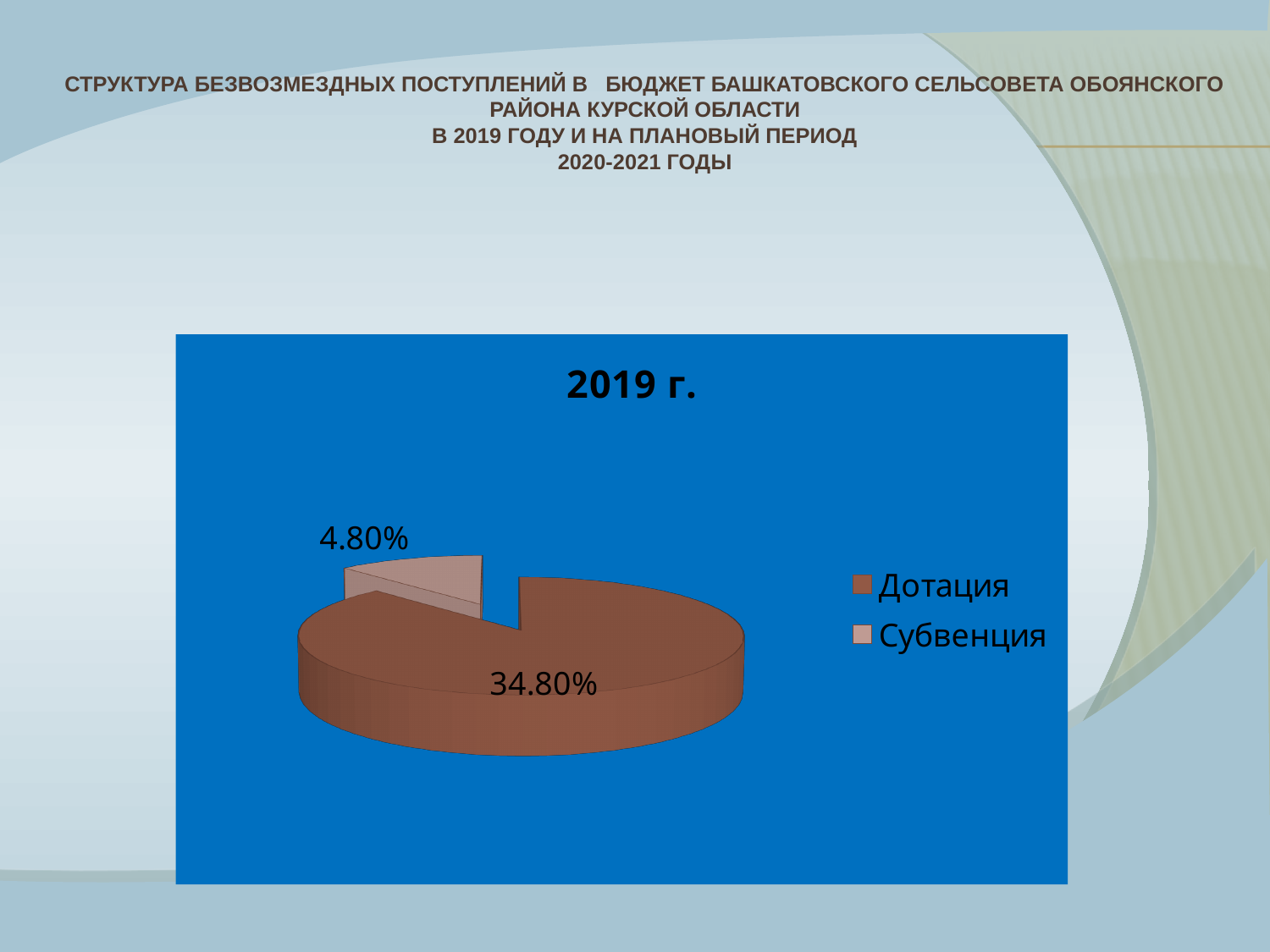
What value is labelled on the Дотация slice? 34.80% How many entries does the legend list? 2 Which is larger, the value for Дотация or the value for Субвенция? Дотация What is the chart's title? 2019 г. How many slices does the pie chart have? 2 Which category has the largest slice of the pie? Дотация What is the difference between the labelled values for Дотация and Субвенция? 30.00% What value is labelled on the Субвенция slice? 4.80% What type of chart is shown on the slide? pie chart Which legend entry is shown in the lighter pink colour? Субвенция Which category has the smallest slice of the pie? Субвенция